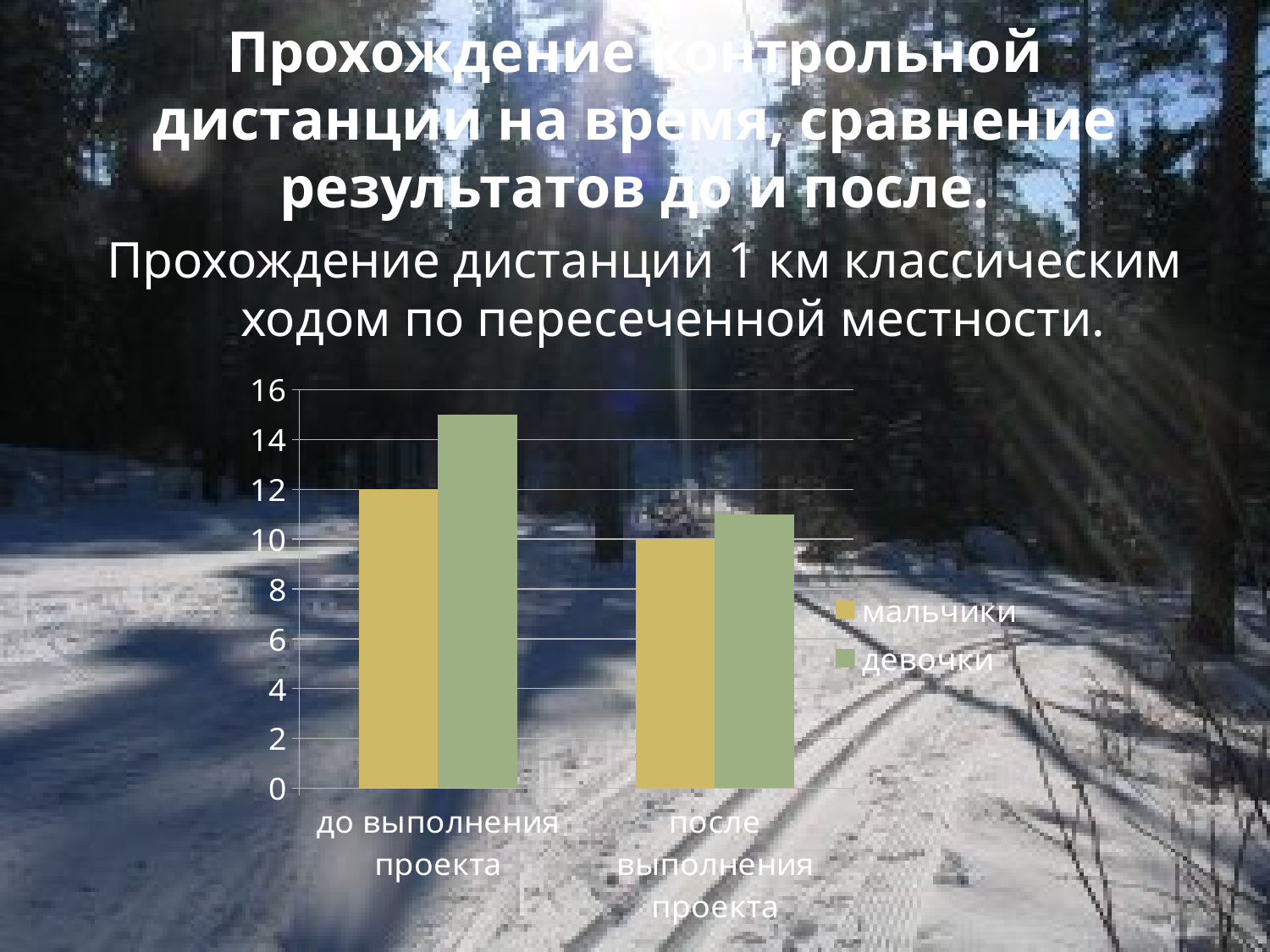
What is the value for мальчики in the category 'до выполнения проекта'? 12 Which series has the higher value in the category 'до выполнения проекта'? девочки What are the two series named in the legend? мальчики, девочки Do the values for девочки rise or fall from 'до выполнения проекта' to 'после выполнения проекта'? fall What kind of chart is shown on the slide? bar chart Which bar is the tallest in the chart? девочки, до выполнения проекта What is the value for мальчики in the category 'после выполнения проекта'? 10 Is the value for девочки in 'до выполнения проекта' greater or less than 14? greater How many series does the legend list? 2 By how much did the value for мальчики change from 'до выполнения проекта' to 'после выполнения проекта'? 2 How many categories are shown on the x axis? 2 Is the value for девочки in 'после выполнения проекта' greater or less than 12? less